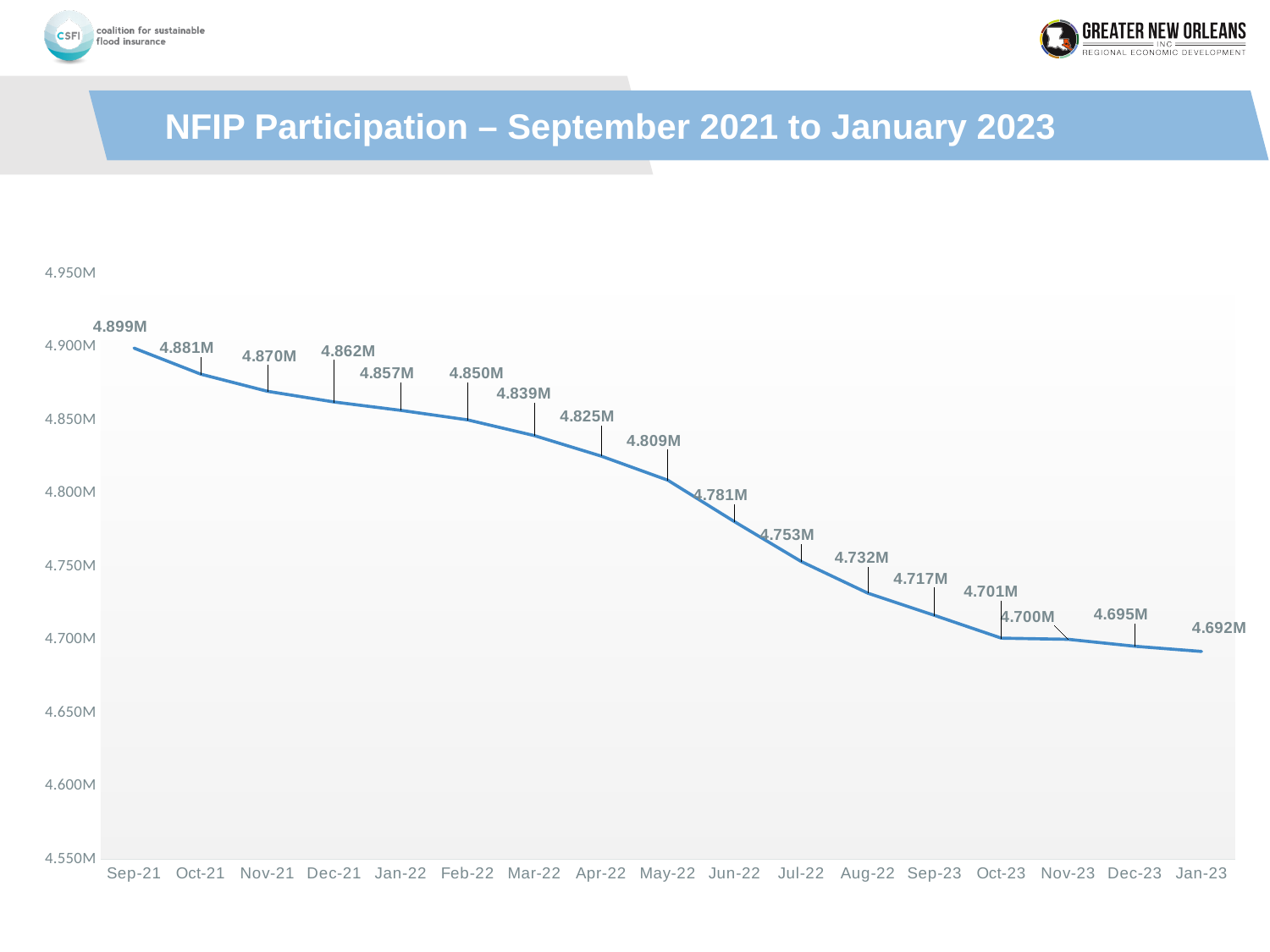
How many data points are plotted on the chart? 17 Which month has the lowest value on the chart? Jan-23 What is the value plotted for Jun-22? 4.781M What is the value plotted for Jan-23? 4.692M What is the difference between the Jun-22 value and the Jul-22 value? 0.028M What type of chart is shown on the slide? Line chart Which is larger, the value for Mar-22 or the value for May-22? Mar-22 What is the value plotted for Aug-22? 4.732M Which month has the highest value on the chart? Sep-21 What is the difference between the Sep-21 value and the Jan-23 value? 0.207M Do the values rise or fall from Sep-21 to Jan-23? Fall What is the NFIP participation value for Sep-21? 4.899M